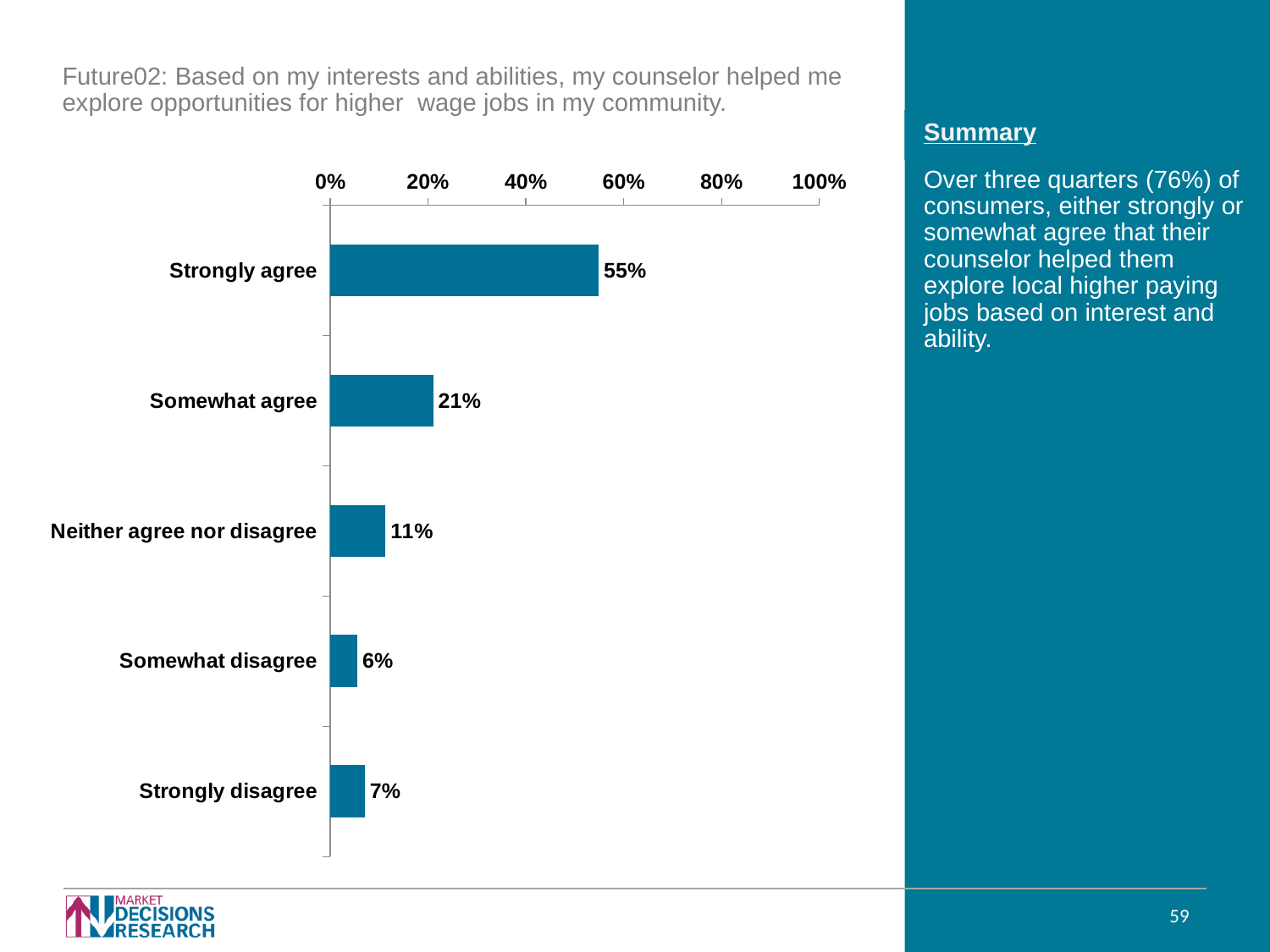
Is the value for 'Strongly agree' greater or less than 40%? greater What is the difference between the 'Strongly agree' and 'Somewhat agree' values? 34 percentage points Which is larger, the value for 'Strongly disagree' or the value for 'Somewhat disagree'? Strongly disagree What is the value shown for 'Somewhat agree'? 21% What is the combined value of 'Strongly agree' and 'Somewhat agree'? 76% What percentage of respondents chose 'Neither agree nor disagree'? 11% What type of chart is shown on the slide? Bar chart What percentage of respondents selected 'Strongly agree'? 55% Which response category has the highest value? Strongly agree How many response categories are shown in the chart? 5 What is the value for 'Strongly disagree'? 7% Which response category has the lowest value? Somewhat disagree